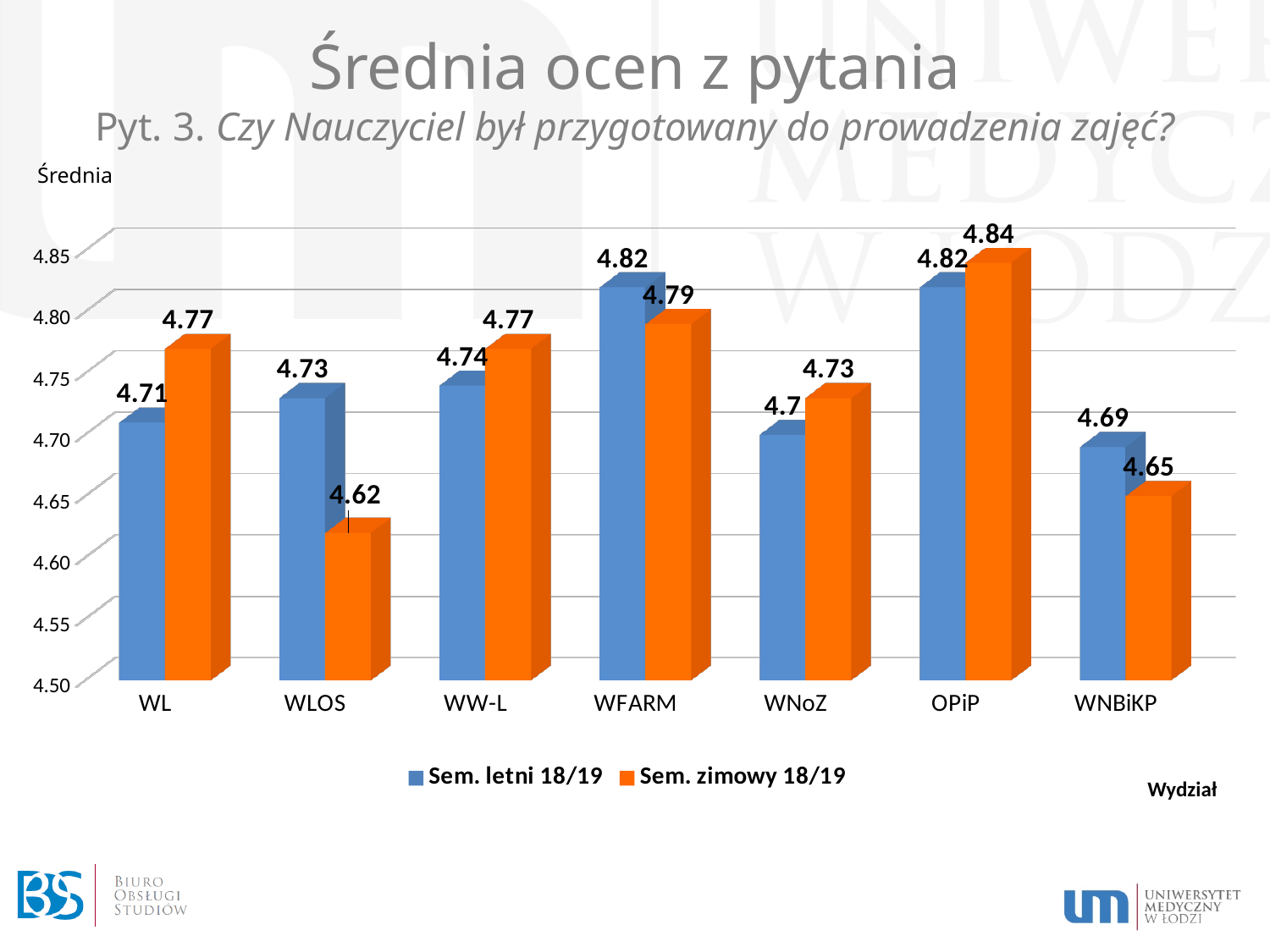
What is the value for WLOS in the Sem. zimowy 18/19 series? 4.62 How many categories are shown on the x axis? 7 Which category has the lowest value in the Sem. letni 18/19 series? WNBiKP How many series does the legend list? 2 What is the value for WFARM in the Sem. letni 18/19 series? 4.82 What is the difference between the Sem. letni 18/19 and Sem. zimowy 18/19 values for WLOS? 0.11 What is the value for WNoZ in the Sem. letni 18/19 series? 4.7 Which category has the highest value in the Sem. zimowy 18/19 series? OPiP For WNBiKP, which series has the larger value: Sem. letni 18/19 or Sem. zimowy 18/19? Sem. letni 18/19 For WL, which series has the larger value: Sem. letni 18/19 or Sem. zimowy 18/19? Sem. zimowy 18/19 Which category has the lowest value in the Sem. zimowy 18/19 series? WLOS What kind of chart is shown on the slide? Bar chart